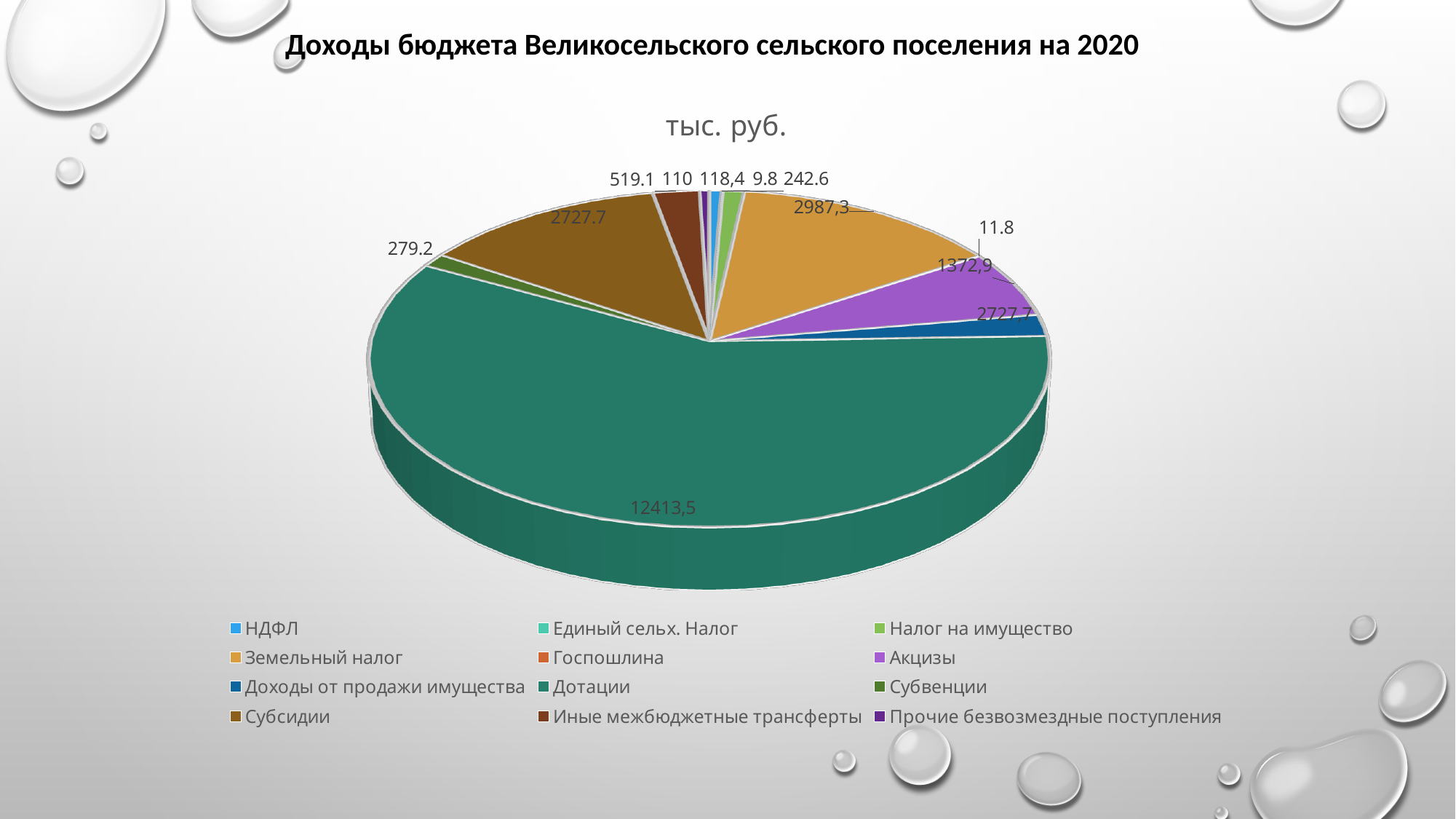
What is the difference between the values for Земельный налог and Акцизы? 1614,4 What kind of chart is shown on the slide? pie chart How many categories does the legend of the pie chart list? 12 What is the value shown for Дотации? 12413,5 What is the value shown for Субвенции? 279.2 What is the value shown for Акцизы? 1372,9 What is the title printed above the pie chart? тыс. руб. Which is larger, Земельный налог or Акцизы? Земельный налог Which category has the largest slice of the pie? Дотации What is the value shown for Субсидии? 2727.7 What is the value shown for Земельный налог? 2987,3 What is the value shown for Иные межбюджетные трансферты? 519.1